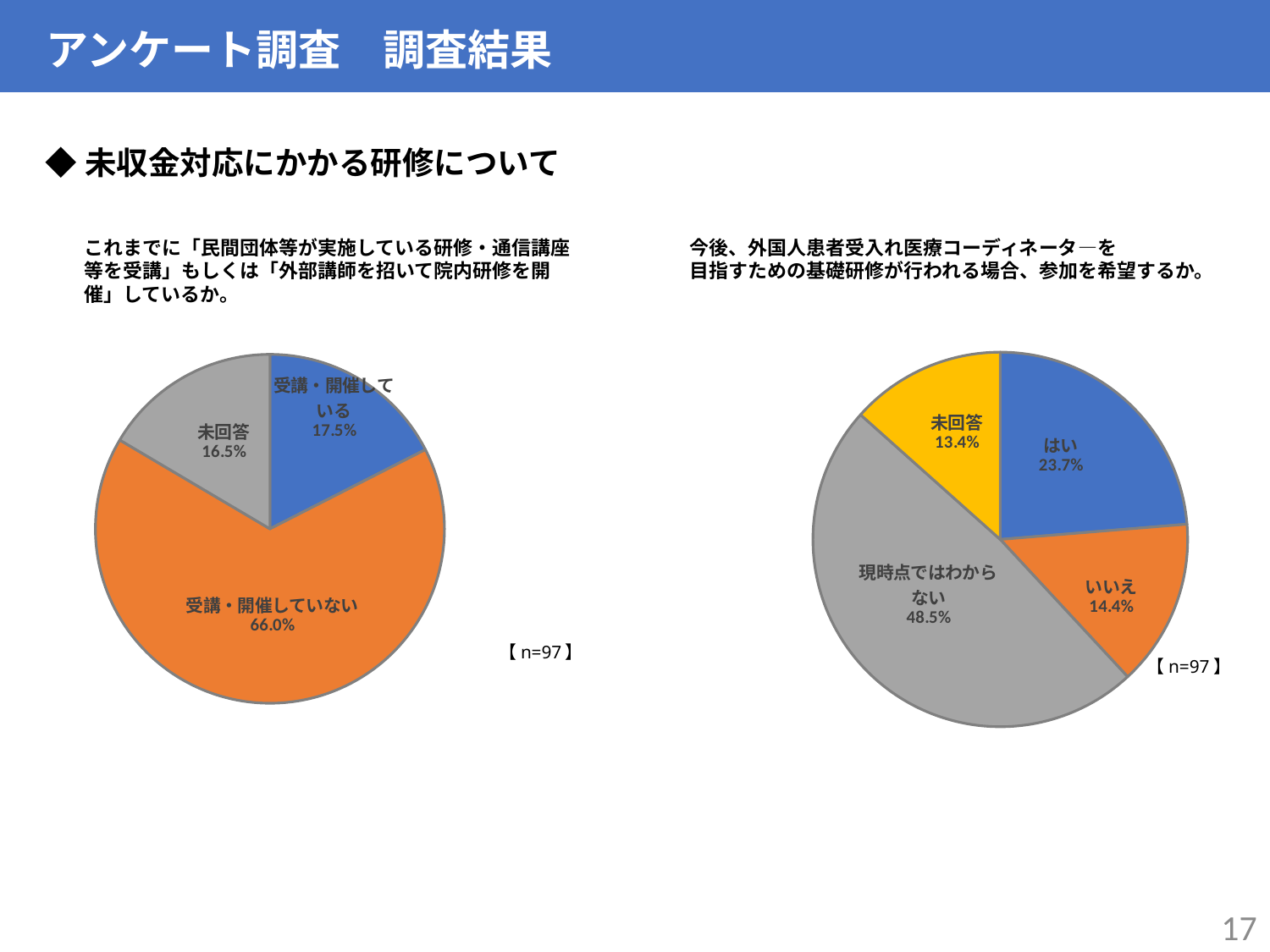
In the left pie chart, how many slices are there? 3 In the left pie chart, what percentage is shown for 受講・開催している? 17.5% In the left pie chart, what percentage is shown for 未回答? 16.5% In the right pie chart, which category has the smallest share? 未回答 In the right pie chart, what percentage is shown for 現時点ではわからない? 48.5% In the right pie chart, which is larger, はい or いいえ? はい In the left pie chart, which category has the largest share? 受講・開催していない In the right pie chart, what percentage is shown for いいえ? 14.4% In the left pie chart, what percentage is shown for 受講・開催していない? 66.0% What type of chart is used on the right side of the slide? Pie chart In the left pie chart, what is the difference between 受講・開催していない and 受講・開催している? 48.5% In the right pie chart, what percentage is shown for はい? 23.7%